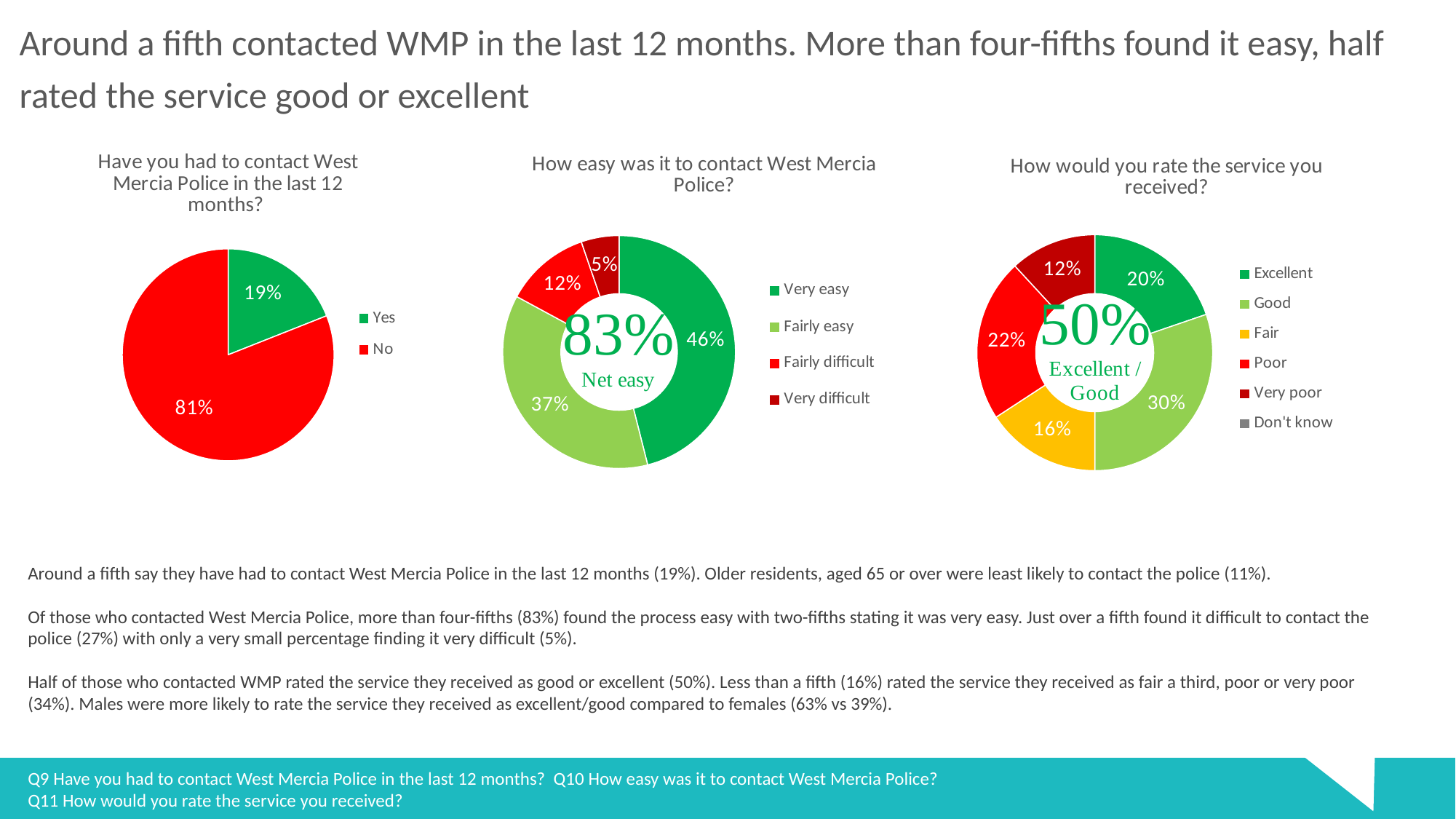
In the chart 'How easy was it to contact West Mercia Police?', what is the difference between Fairly easy and Fairly difficult? 25 percentage points In the chart 'How would you rate the service you received?', what percentage rated the service Good? 30% What net figure is printed in the centre of the chart 'How easy was it to contact West Mercia Police?' 83% Net easy What kind of chart is 'Have you had to contact West Mercia Police in the last 12 months?' Pie chart In the chart 'How would you rate the service you received?', is the share for Poor larger or smaller than the share for Fair? Larger In the chart 'How easy was it to contact West Mercia Police?', what percentage said Very easy? 46% In the chart 'How easy was it to contact West Mercia Police?', what percentage said Very difficult? 5% In the chart 'How easy was it to contact West Mercia Police?', which category has the largest share? Very easy In the chart 'How would you rate the service you received?', which category has the smallest labelled share? Very poor How many categories does the legend of 'How easy was it to contact West Mercia Police?' list? 4 In the chart 'Have you had to contact West Mercia Police in the last 12 months?', what percentage answered Yes? 19% In the chart 'Have you had to contact West Mercia Police in the last 12 months?', what percentage answered No? 81%